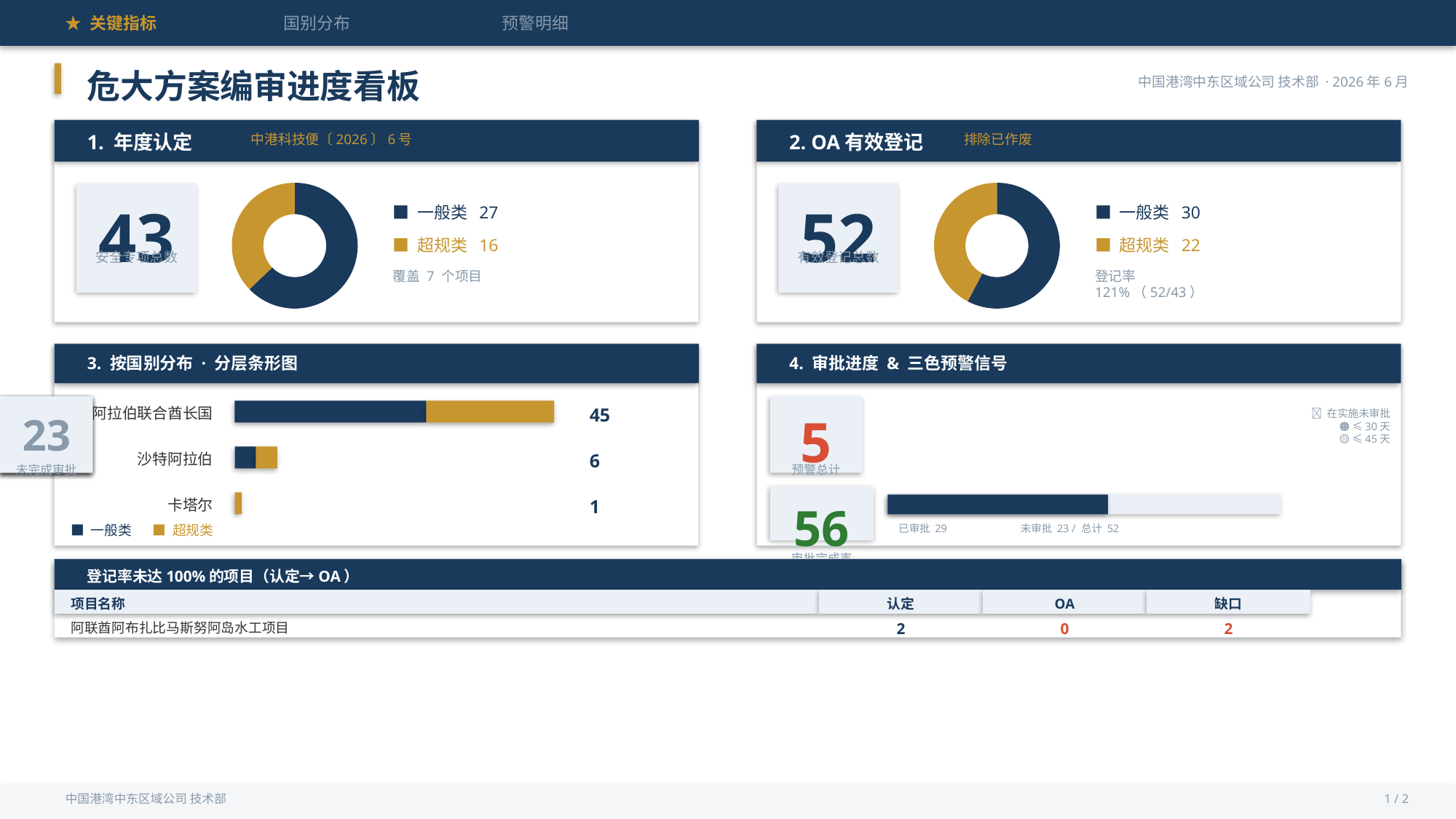
In the chart titled "3. 按国别分布 · 分层条形图", how many series does the legend list? 2 In the chart titled "2. OA 有效登记", what is the value for 超规类? 22 In the chart titled "3. 按国别分布 · 分层条形图", what is the difference between 阿拉伯联合酋长国 and 沙特阿拉伯? 39 In the chart titled "1. 年度认定", what is the value for 超规类? 16 In the chart titled "3. 按国别分布 · 分层条形图", which country has the lowest value? 卡塔尔 In the chart titled "2. OA 有效登记", what kind of chart is shown? Donut chart In the chart titled "3. 按国别分布 · 分层条形图", what is the total value for 阿拉伯联合酋长国? 45 In the chart titled "3. 按国别分布 · 分层条形图", which country has the highest value? 阿拉伯联合酋长国 In the chart titled "1. 年度认定", what is the difference between 一般类 and 超规类? 11 In the chart titled "3. 按国别分布 · 分层条形图", how many countries are shown? 3 In the chart titled "1. 年度认定", what is the value for 一般类? 27 In the chart titled "2. OA 有效登记", which category is larger, 一般类 or 超规类? 一般类